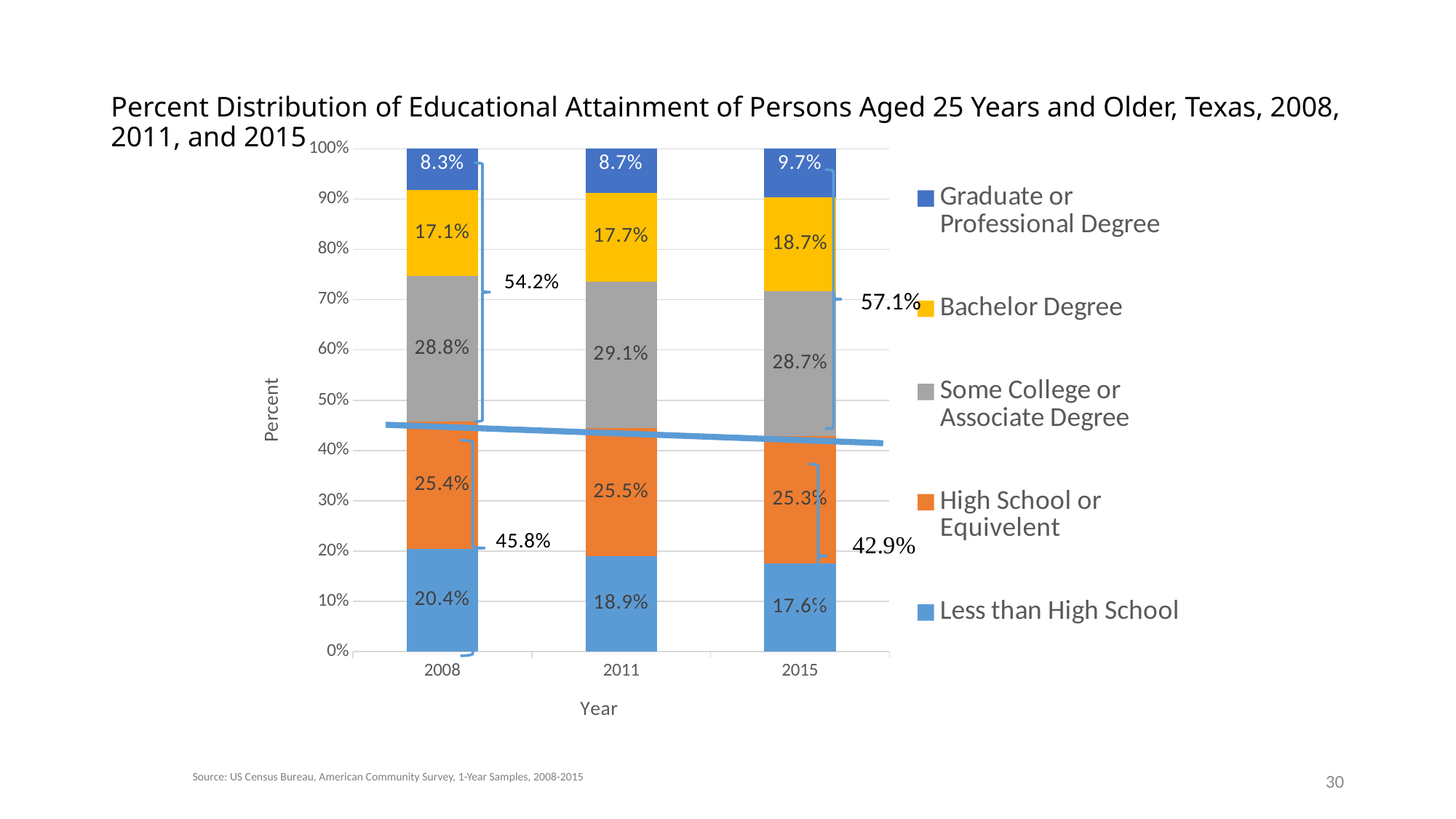
Does the Graduate or Professional Degree share rise or fall from 2008 to 2015? Rise How many educational attainment categories does the legend list? 5 What is the value for Graduate or Professional Degree in 2015? 9.7% What is the Bachelor Degree share in 2011? 17.7% In which year is the Less than High School share the lowest? 2015 In which year is the Graduate or Professional Degree share the highest? 2015 By how many percentage points did the Bachelor Degree share increase from 2008 to 2015? 1.6 percentage points How many years are shown on the x axis? 3 Which year has the larger Some College or Associate Degree share, 2011 or 2015? 2011 What kind of chart is shown on the slide? Stacked bar chart By how many percentage points did the Less than High School share fall from 2008 to 2015? 2.8 percentage points What percentage of persons aged 25 and older in Texas had less than a high school education in 2008? 20.4%